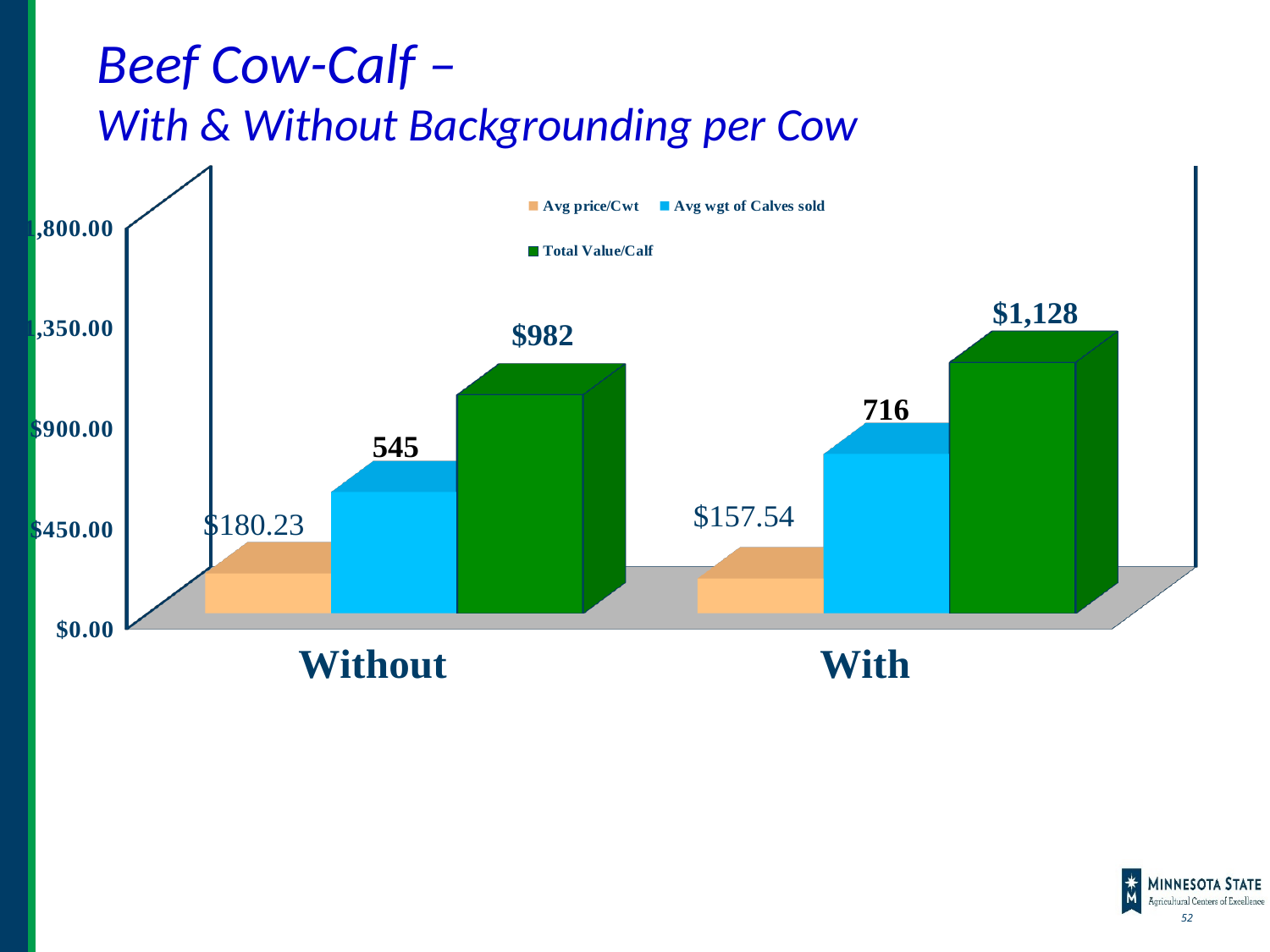
What is the Avg wgt of Calves sold for the With category? 716 How many series does the legend list? 3 What is the difference in Total Value/Calf between With and Without? $146 How many categories are shown on the x axis? 2 What is the Total Value/Calf for the With category? $1,128 What is the Avg wgt of Calves sold for the Without category? 545 What is the difference in Avg wgt of Calves sold between With and Without? 171 What is the Avg price/Cwt for the With category? $157.54 What is the Total Value/Calf for the Without category? $982 Which category has the higher Total Value/Calf? With What kind of chart is shown on the slide? Bar chart What is the Avg price/Cwt for the Without category? $180.23